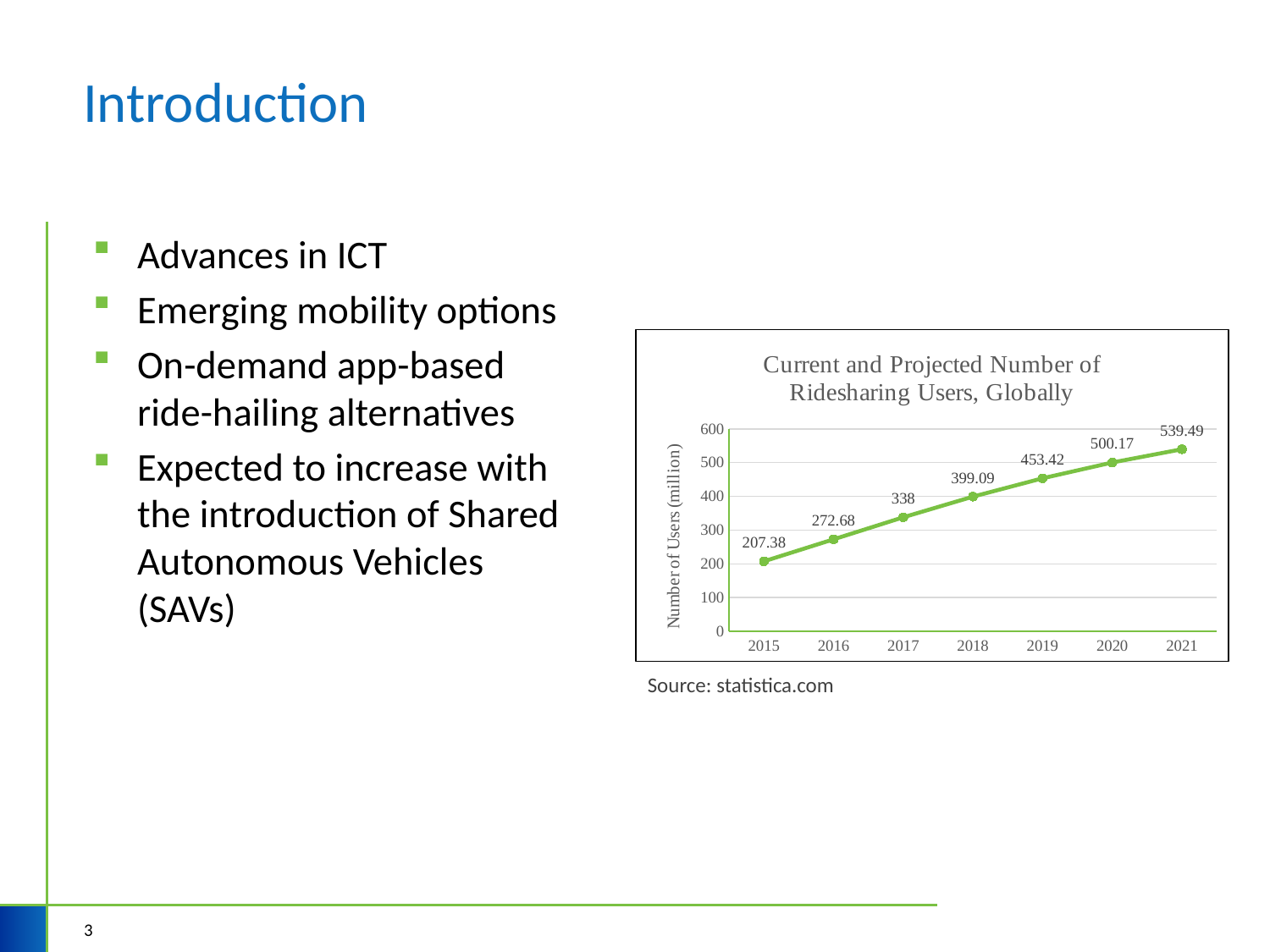
What is the difference in ridesharing users (million) between 2021 and 2015? 332.11 Which year has more ridesharing users, 2019 or 2017? 2019 Do the values rise or fall from 2015 to 2021? rise Which year has the highest number of ridesharing users? 2021 What is the number of ridesharing users (million) for 2021? 539.49 What is the number of ridesharing users (million) for 2015? 207.38 How many years are plotted on the chart? 7 What kind of chart is shown on the slide? line chart Is the value for 2020 greater or less than 400? greater Which year has the lowest number of ridesharing users? 2015 What is the difference in ridesharing users (million) between 2017 and 2016? 65.32 What is the number of ridesharing users (million) for 2018? 399.09